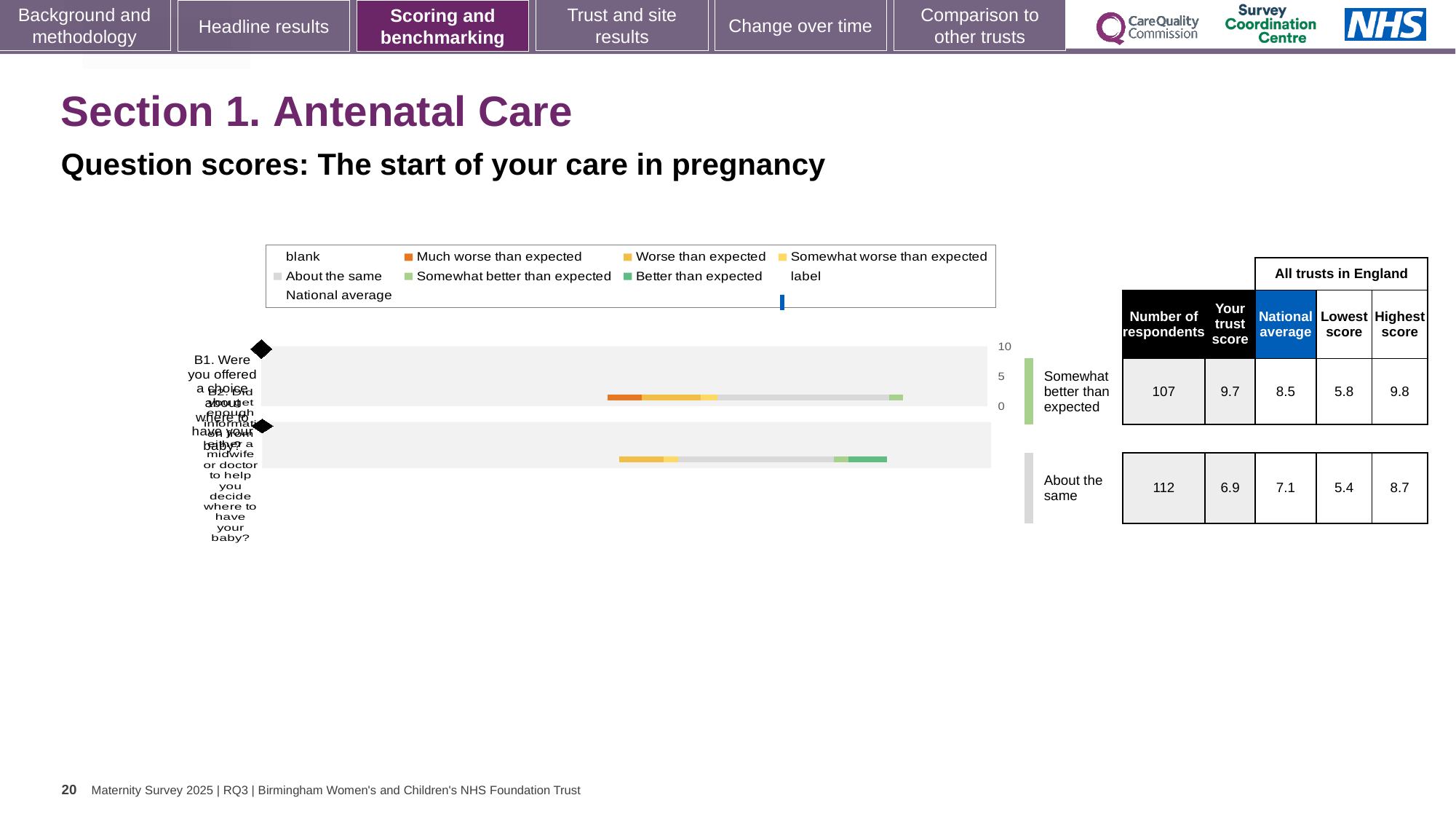
In the table beside the chart, what is the lowest score for the row rated 'About the same'? 5.4 For the row rated 'About the same', what is the difference between the national average and your trust score? 0.2 In the table beside the chart, what is the number of respondents for the row rated 'Somewhat better than expected'? 107 In the table beside the chart, what is 'Your trust score' for the row rated 'Somewhat better than expected'? 9.7 Which row has more respondents, the one rated 'Somewhat better than expected' or the one rated 'About the same'? About the same What heading appears above the 'National average', 'Lowest score' and 'Highest score' columns in the table? All trusts in England For the row rated 'Somewhat better than expected', what is the difference between your trust score and the national average? 1.2 What kind of chart is shown on the slide? Bar chart How many question rows are plotted in the chart? 2 Which row has the higher 'Your trust score'? Somewhat better than expected In the table beside the chart, what is the national average for the row rated 'About the same'? 7.1 In the table beside the chart, what is the highest score for the row rated 'Somewhat better than expected'? 9.8